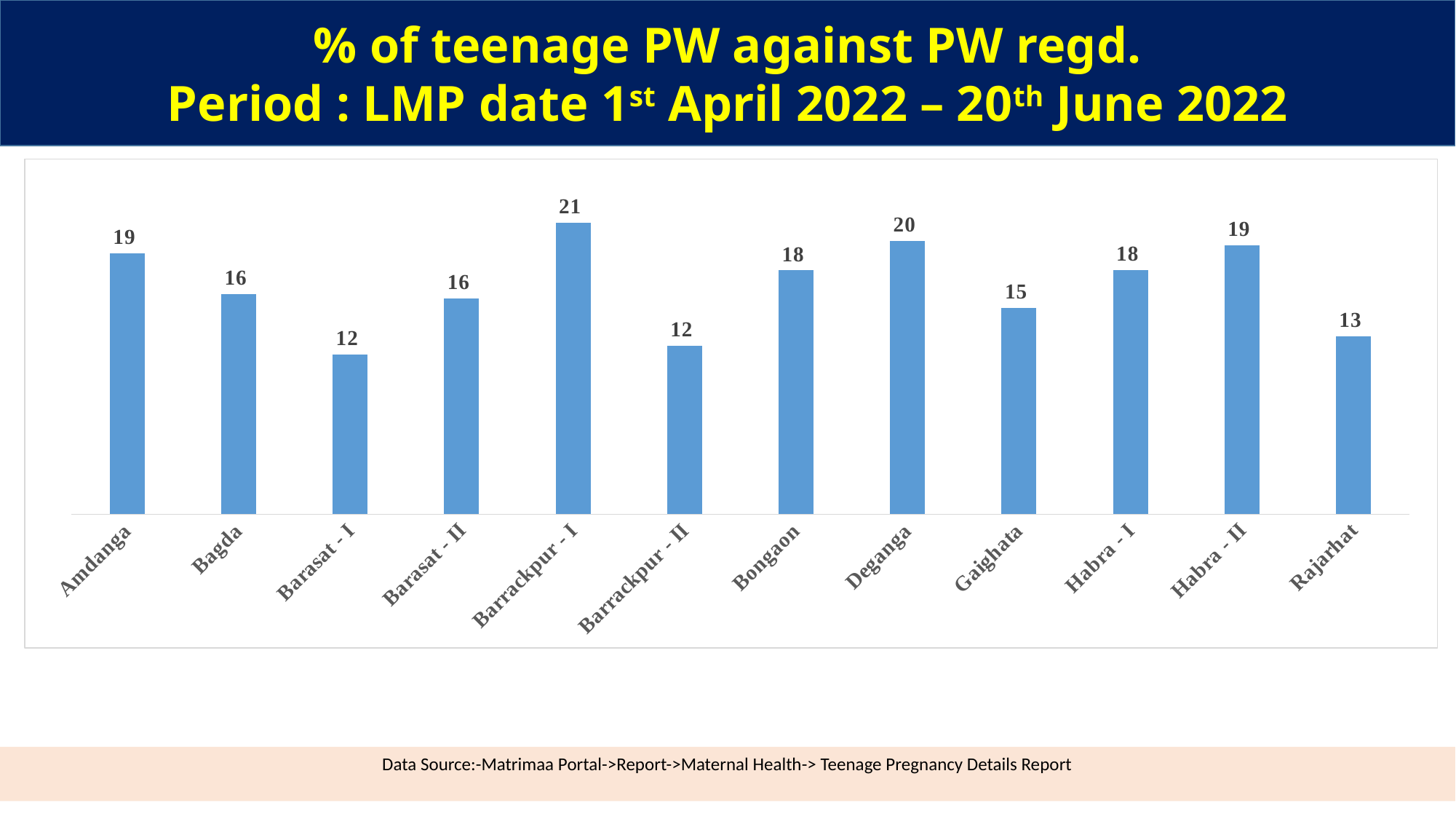
What is the difference between the values for Barrackpur - I and Barasat - I? 9 What is the value for Gaighata? 15 What is the value for Rajarhat? 13 Which is larger, the value for Habra - II or the value for Habra - I? Habra - II What is the data source stated at the bottom of the slide? Matrimaa Portal->Report->Maternal Health-> Teenage Pregnancy Details Report What is the value for Barrackpur - I? 21 Which category has the highest value? Barrackpur - I What kind of chart is shown on the slide? Bar chart How many categories are shown on the x axis? 12 What is the value for Deganga? 20 Which is larger, the value for Amdanga or the value for Bagda? Amdanga What is the difference between the values for Deganga and Gaighata? 5